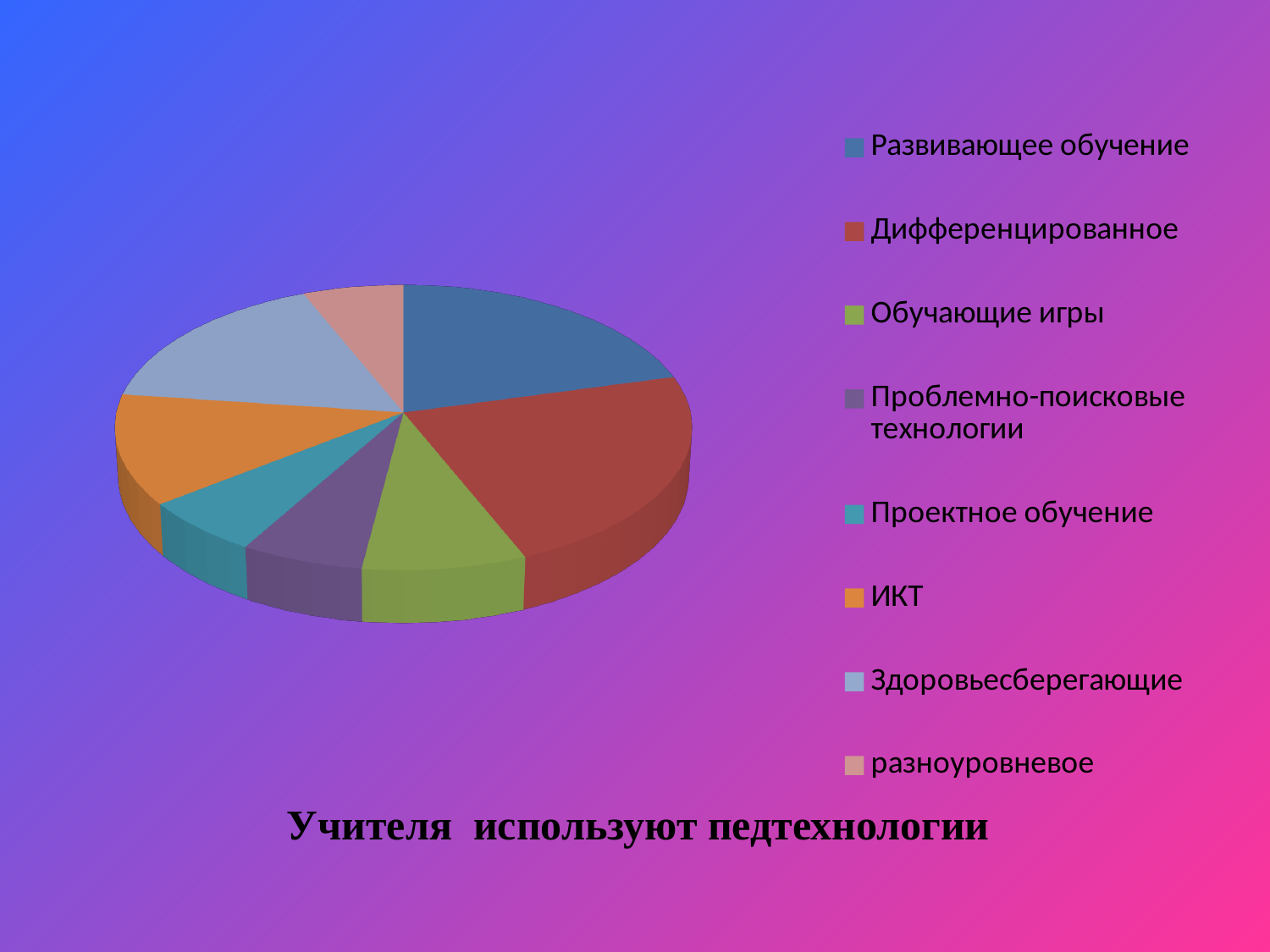
Which slice is larger: ИКТ or Проблемно-поисковые технологии? ИКТ What is the title text shown below the pie chart? Учителя используют педтехнологии Which category has the largest slice of the pie chart? Дифференцированное How many categories does the pie chart's legend list? 8 Which slice is larger: Здоровьесберегающие or разноуровневое? Здоровьесберегающие Which slice is larger: Развивающее обучение or Проектное обучение? Развивающее обучение What kind of chart is shown on the slide? pie chart Which legend entry is shown in green? Обучающие игры